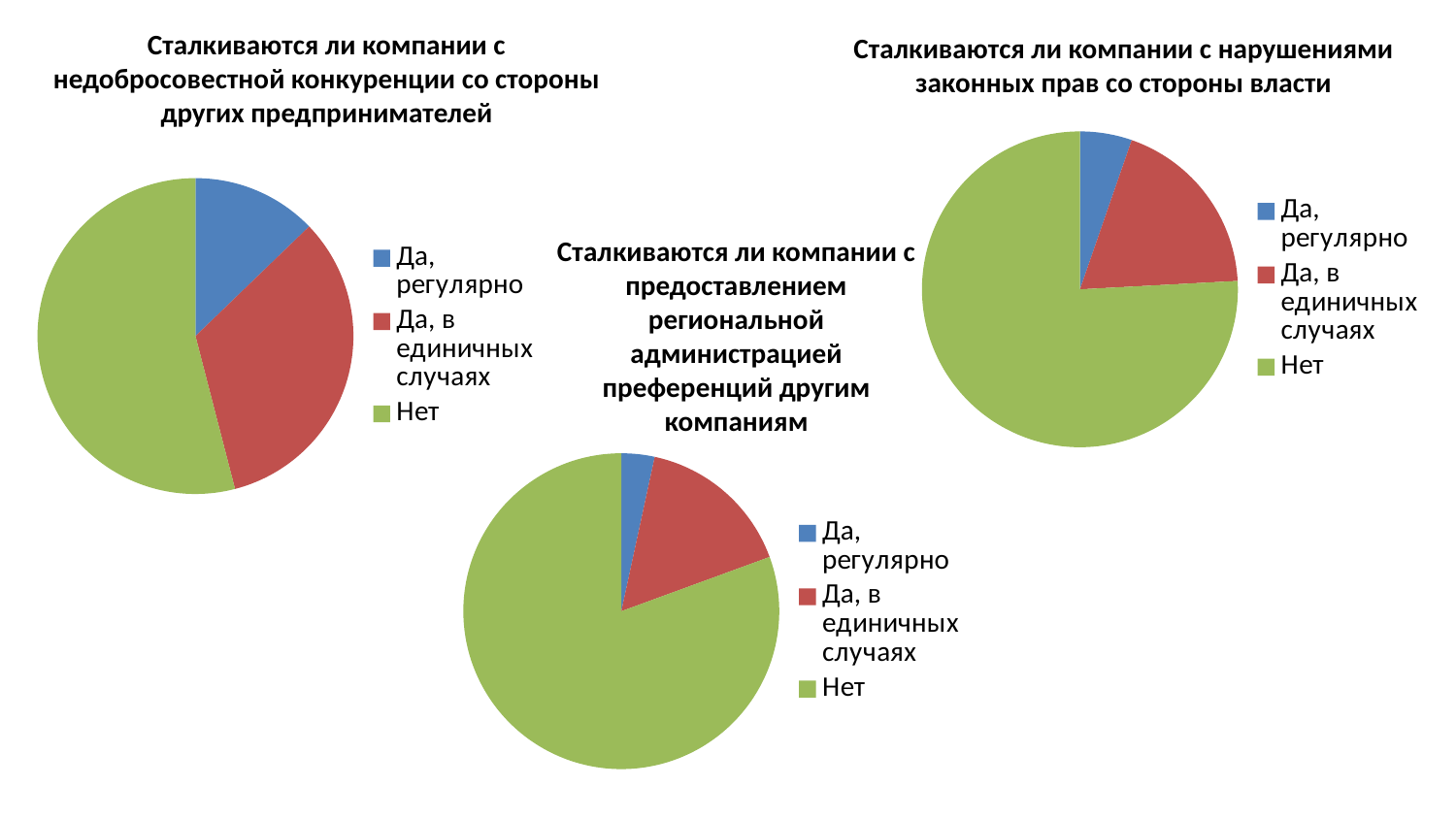
In the left chart about unfair competition from other entrepreneurs, which category has the largest slice? Нет In the right chart about violations of legal rights by authorities, which category has the smallest slice? Да, регулярно In the middle chart about regional administration preferences to other companies, which category has the largest slice? Нет How many slices does the right chart titled "Сталкиваются ли компании с нарушениями законных прав со стороны власти" have? 3 In the left chart about unfair competition from other entrepreneurs, which category has the smallest slice? Да, регулярно In the left chart about unfair competition from other entrepreneurs, which slice is larger: "Да, в единичных случаях" or "Да, регулярно"? Да, в единичных случаях What kind of chart is the left chart titled "Сталкиваются ли компании с недобросовестной конкуренции со стороны других предпринимателей"? Pie chart In the right chart about violations of legal rights by authorities, which category has the largest slice? Нет What colour is the "Нет" slice in the middle chart about regional administration preferences to other companies? Green In the right chart about violations of legal rights by authorities, which slice is larger: "Нет" or "Да, в единичных случаях"? Нет How many entries does the legend of the middle chart titled "Сталкиваются ли компании с предоставлением региональной администрацией преференций другим компаниям" list? 3 In the middle chart about regional administration preferences to other companies, which category has the smallest slice? Да, регулярно